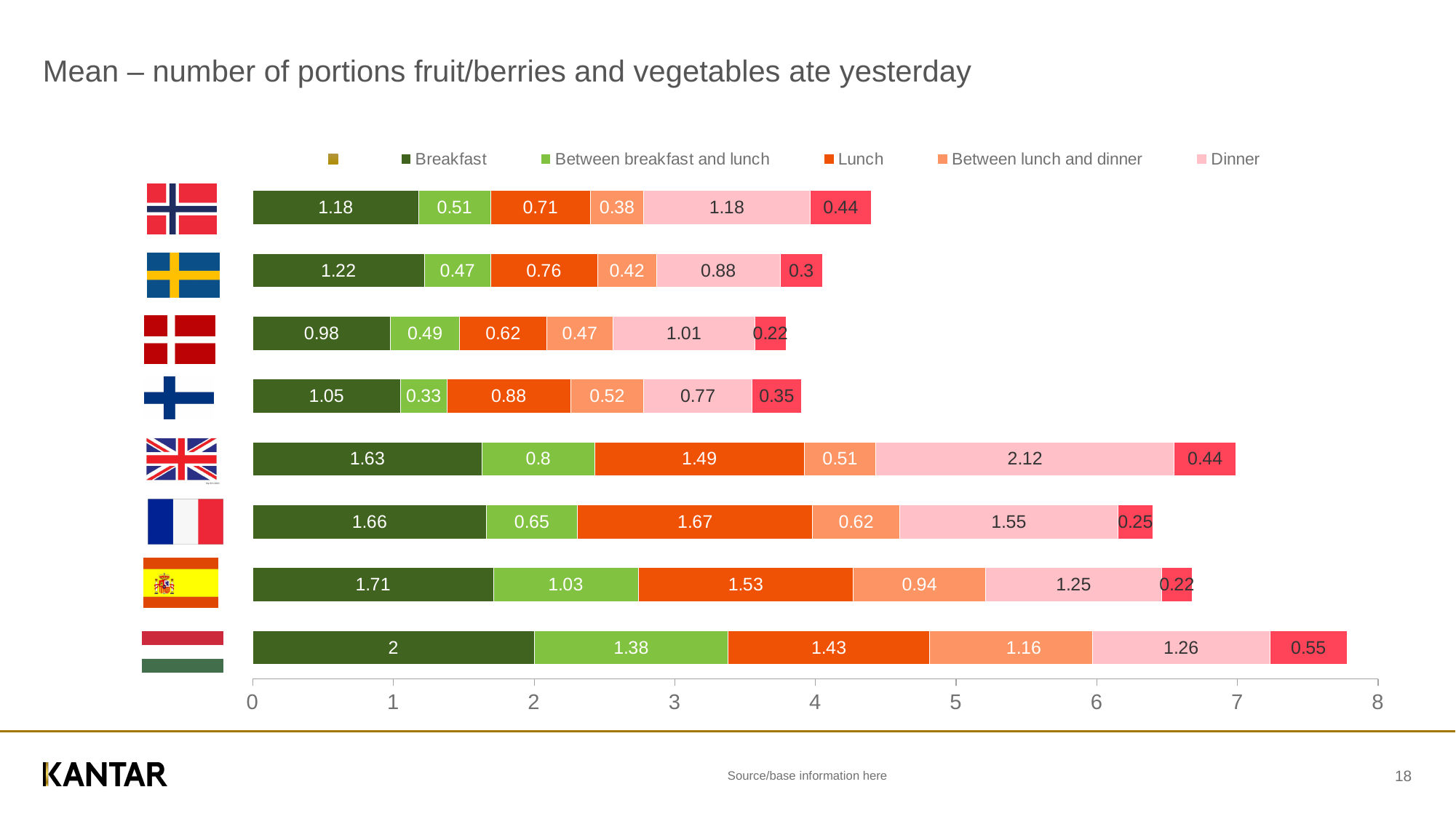
What is the title of the slide? Mean – number of portions fruit/berries and vegetables ate yesterday What is the Lunch value for the top bar (Norwegian flag)? 0.71 What is the difference between the Lunch value of the sixth bar (French flag) and the Lunch value of the seventh bar (Spanish flag)? 0.14 What kind of chart is shown on the slide? Stacked bar chart What is the Between lunch and dinner value for the seventh bar from the top (Spanish flag)? 0.94 What is the Dinner value for the fifth bar from the top (UK flag)? 2.12 Which has the larger Dinner value: the fifth bar (UK flag) or the sixth bar (French flag)? The fifth bar (UK flag) How many bars (countries) are shown in the chart? 8 Which bar has the lowest Breakfast value? The third bar from the top (Danish flag), 0.98 Which bar has the highest Breakfast value? The bottom bar (Hungarian flag), 2 What is the total of all segments in the bottom bar (Hungarian flag)? 7.78 What is the Breakfast value for the bottom bar (Hungarian flag)? 2